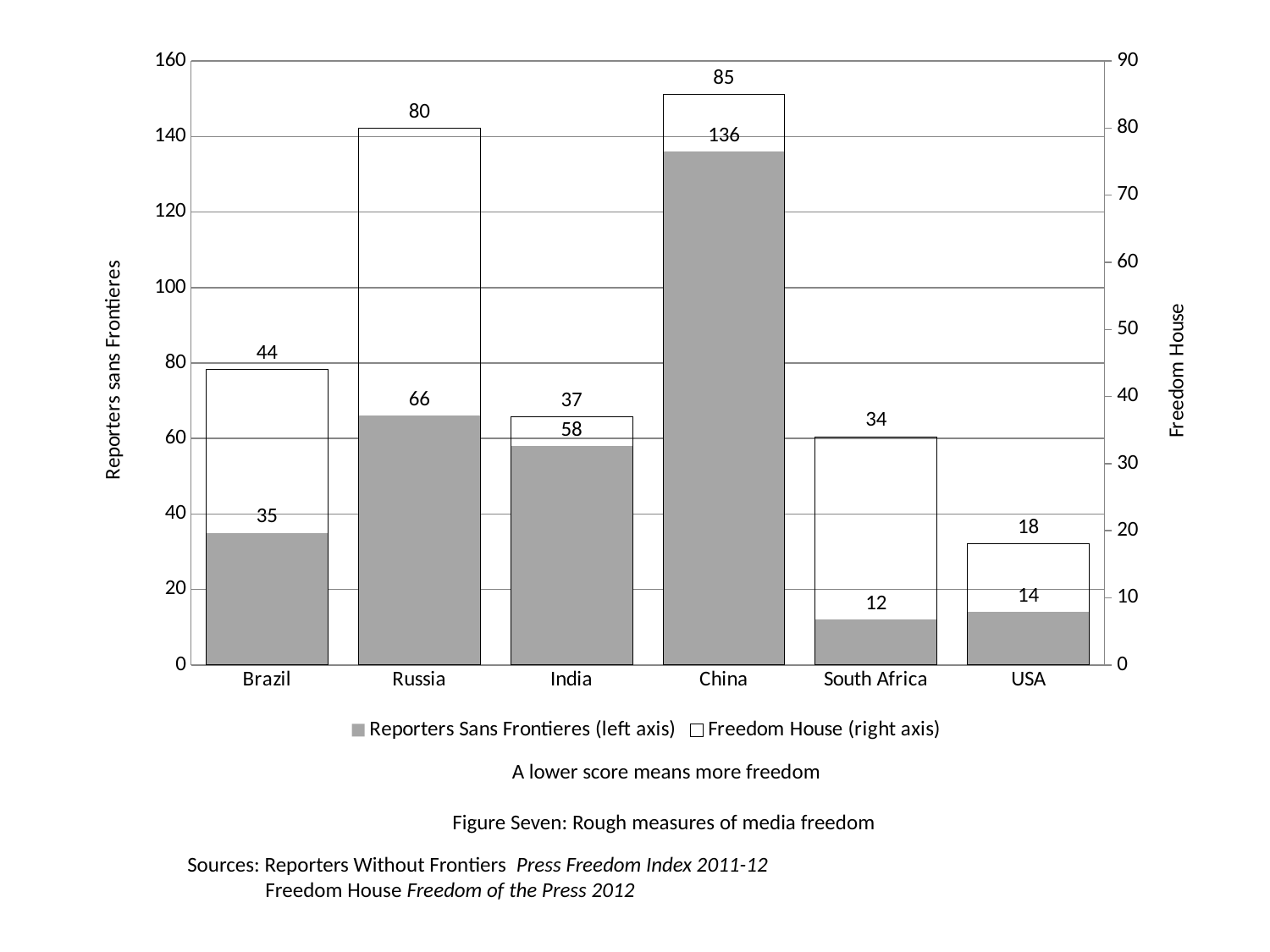
What is the Reporters Sans Frontieres score for China? 136 How many countries are shown on the x axis? 6 What kind of chart is shown on the slide? Bar chart Is the Reporters Sans Frontieres value for Russia greater or less than 60? greater Which country has the lowest Freedom House score? USA What is the difference between the Reporters Sans Frontieres scores of China and Russia? 70 Which has the larger Freedom House score, India or South Africa? India What is the Reporters Sans Frontieres score for South Africa? 12 What is the Freedom House score for Russia? 80 Which country has the highest Reporters Sans Frontieres score? China What is the Freedom House score for Brazil? 44 How many series does the legend list? 2